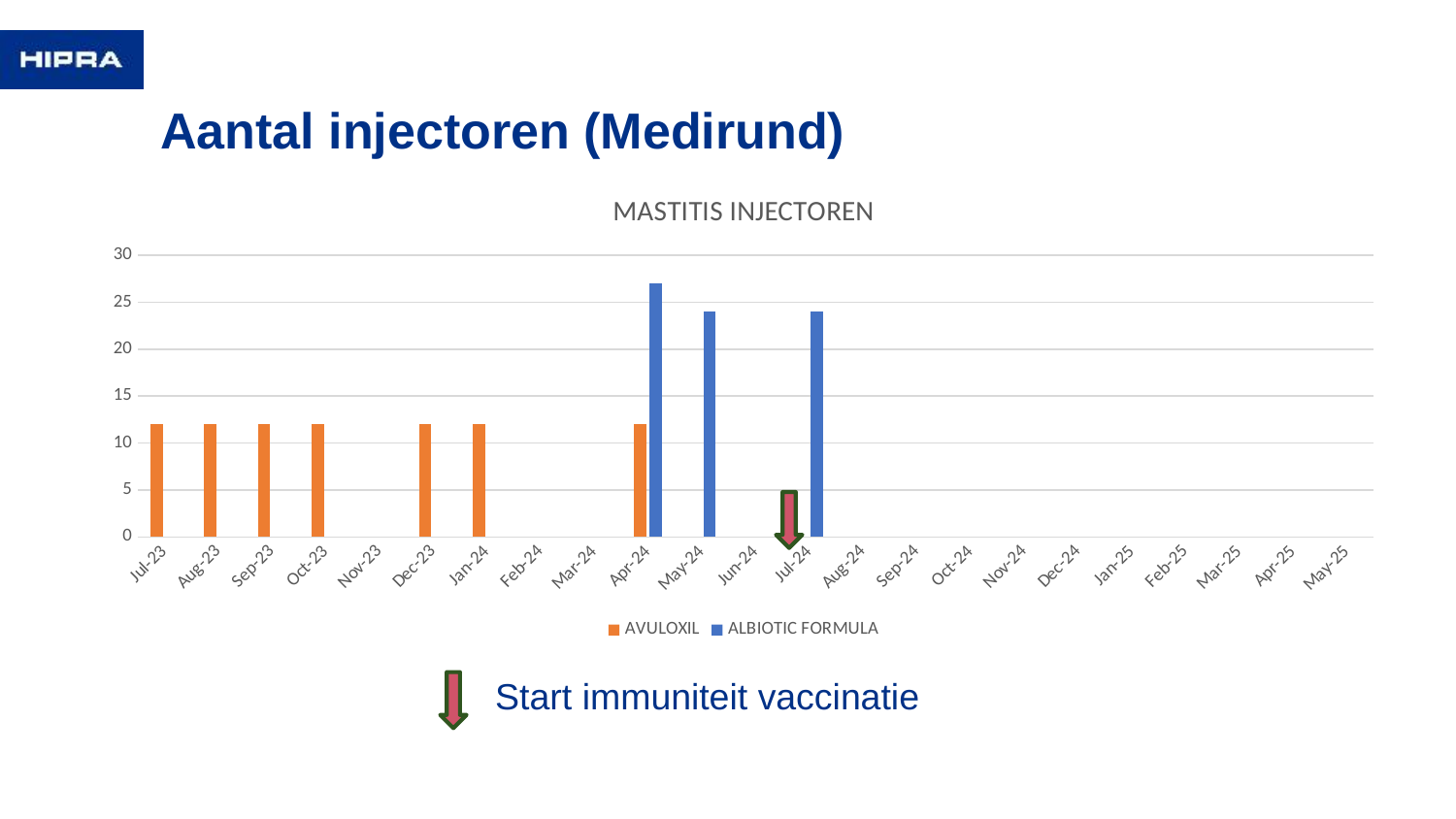
Is the ALBIOTIC FORMULA value for May-24 greater or less than 20? greater How many months are shown on the x axis of the MASTITIS INJECTOREN chart? 23 What kind of chart is the MASTITIS INJECTOREN chart? bar chart In Apr-24, which series has the larger value, AVULOXIL or ALBIOTIC FORMULA? ALBIOTIC FORMULA Is the AVULOXIL value for Jul-23 greater or less than 15? less What are the two series named in the legend of the MASTITIS INJECTOREN chart? AVULOXIL and ALBIOTIC FORMULA Which series in the MASTITIS INJECTOREN chart is shown in orange? AVULOXIL How many series does the legend of the MASTITIS INJECTOREN chart list? 2 In how many months does the MASTITIS INJECTOREN chart show an ALBIOTIC FORMULA bar? 3 Which month has the highest ALBIOTIC FORMULA value in the MASTITIS INJECTOREN chart? Apr-24 In how many months does the MASTITIS INJECTOREN chart show an AVULOXIL bar? 7 Is the ALBIOTIC FORMULA value for Apr-24 greater or less than 25? greater